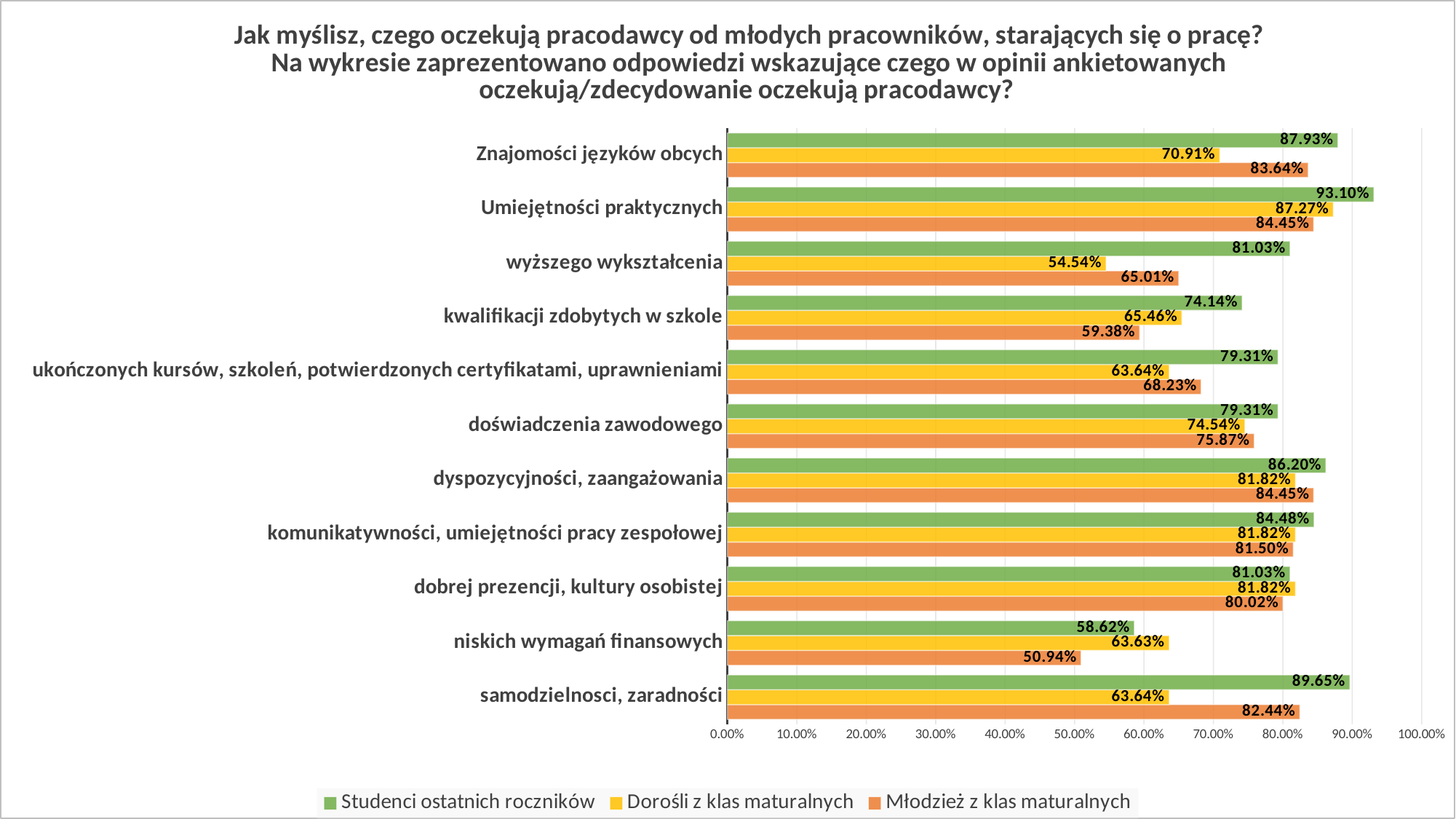
Which colour represents Młodzież z klas maturalnych in the legend? Orange What kind of chart is shown on the slide? Bar chart Which category has the lowest value for Młodzież z klas maturalnych? niskich wymagań finansowych Which category has the highest value for Studenci ostatnich roczników? Umiejętności praktycznych What percentage of Studenci ostatnich roczników indicated Umiejętności praktycznych? 93.10% What is the value for Młodzież z klas maturalnych for niskich wymagań finansowych? 50.94% What is the value for Dorośli z klas maturalnych for wyższego wykształcenia? 54.54% How many categories are shown on the chart? 11 For niskich wymagań finansowych, which is larger: the value for Dorośli z klas maturalnych or for Studenci ostatnich roczników? Dorośli z klas maturalnych Which category has the lowest value for Dorośli z klas maturalnych? wyższego wykształcenia How many series does the legend list? 3 For Znajomości języków obcych, what is the difference between the Studenci ostatnich roczników value and the Dorośli z klas maturalnych value? 17.02 percentage points